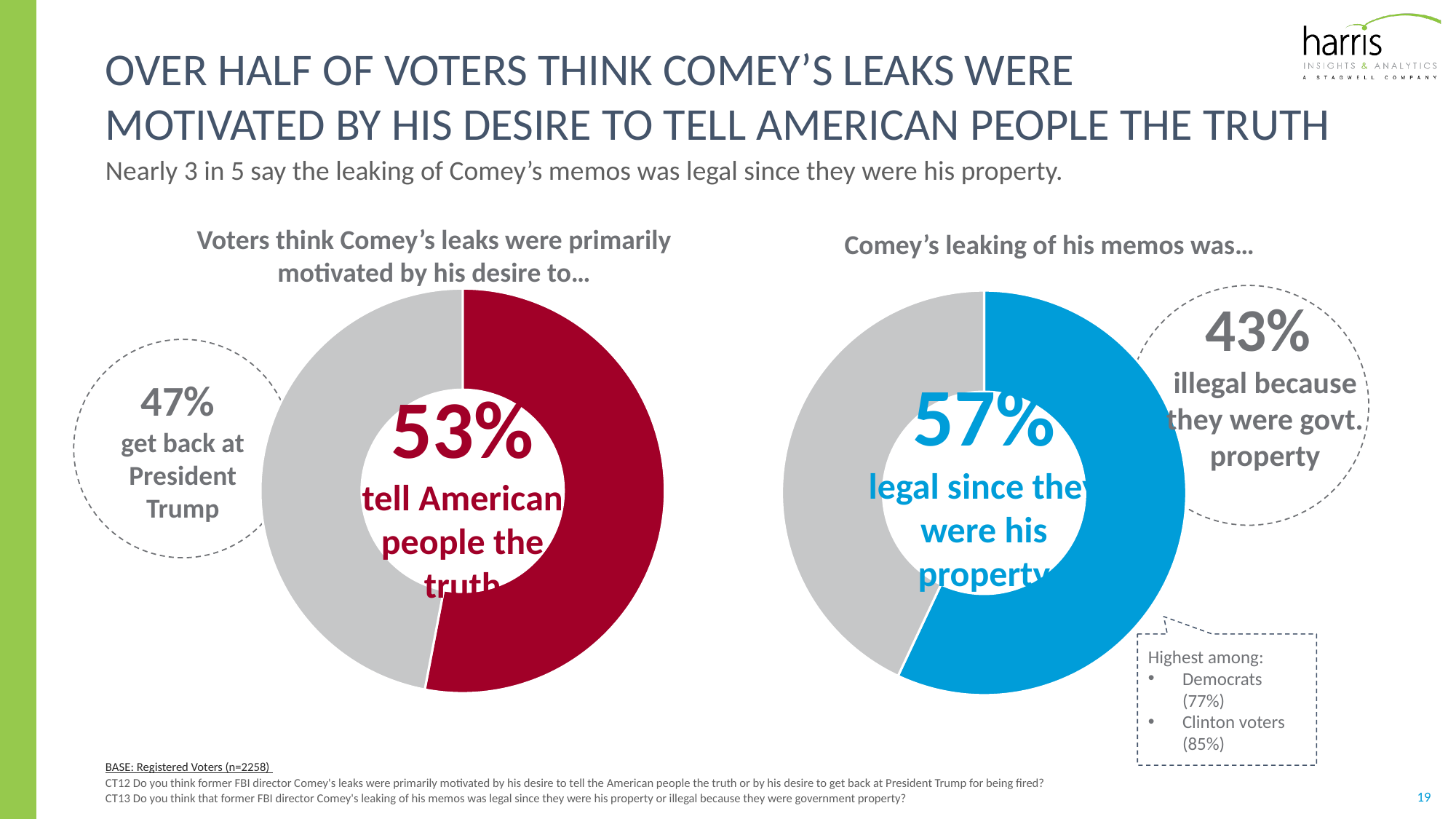
In the left chart, what share of voters say Comey's leaks were motivated by a desire to get back at President Trump? 47% In the right chart, what share of voters say the leaking was illegal because the memos were government property? 43% What type of chart is used on the left side of the slide? Donut (pie) chart How many segments does the right chart, 'Comey's leaking of his memos was…', have? 2 In the right chart, what colour is the segment representing 'legal since they were his property'? Blue In the right chart, 'Comey's leaking of his memos was…', what share of voters say the leaking was legal since the memos were his property? 57% In the right chart, which response has the smaller share? illegal because they were govt. property In the left chart, what is the difference in percentage points between the 'tell American people the truth' share and the 'get back at President Trump' share? 6 percentage points In the left chart, 'Voters think Comey's leaks were primarily motivated by his desire to…', what share of voters say the leaks were motivated by a desire to tell American people the truth? 53% According to the callout next to the right chart, what percentage of Clinton voters say the leaking was legal? 85% In the left chart, which response has the larger share: 'tell American people the truth' or 'get back at President Trump'? tell American people the truth In the right chart, what is the difference in percentage points between the 'legal' share and the 'illegal' share? 14 percentage points